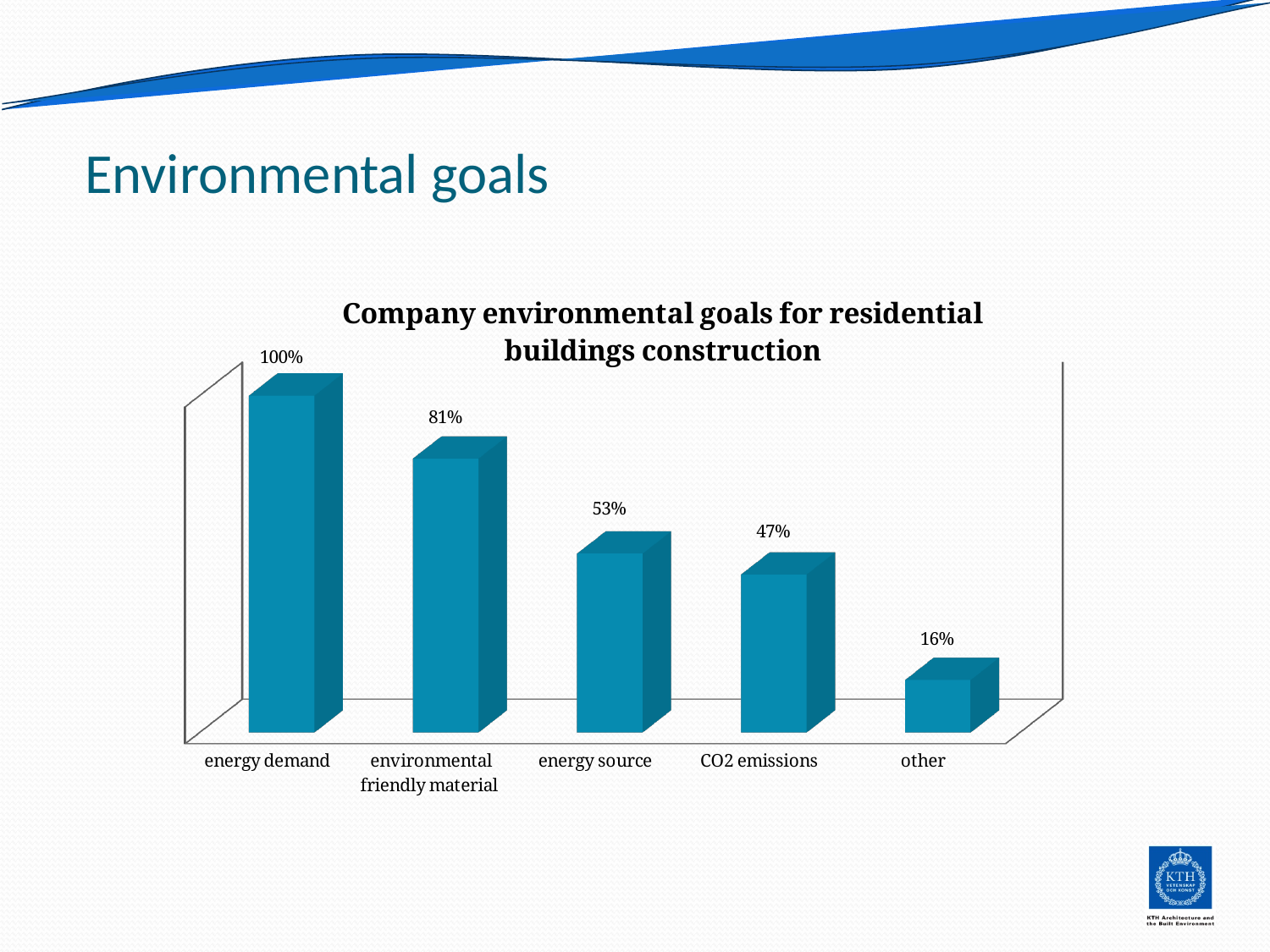
What is the value for environmental friendly material? 81% What is the value for energy demand? 100% What is the value for energy source? 53% Which is larger, the value for environmental friendly material or the value for energy source? environmental friendly material What is the value for other? 16% Which category has the lowest value? other Which category has the highest value? energy demand What kind of chart is shown on the slide? bar chart What is the difference between the values for energy demand and environmental friendly material? 19% What is the difference between the values for energy source and CO2 emissions? 6% What is the value for CO2 emissions? 47% How many categories are shown in the chart? 5